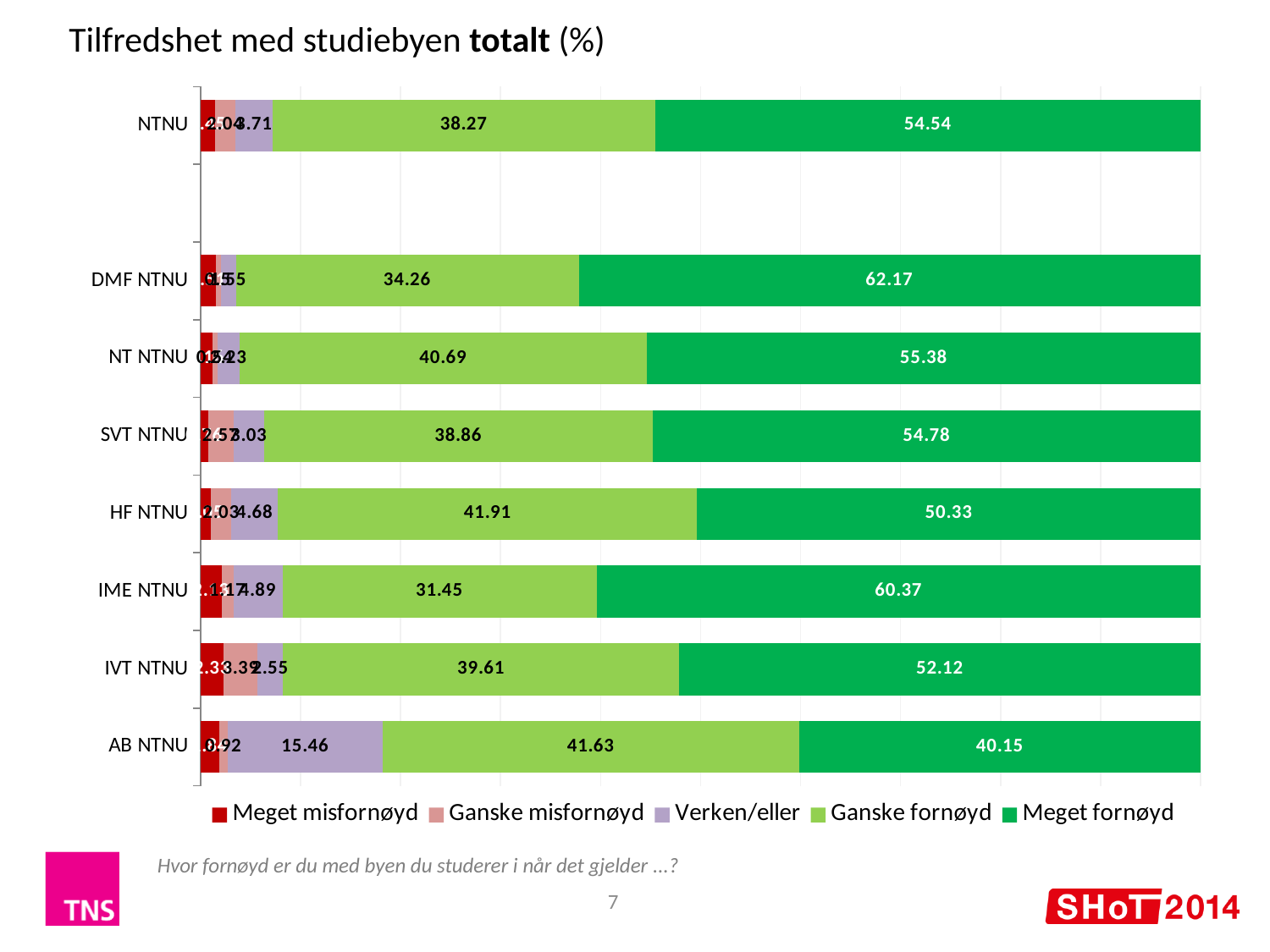
What is the title of the chart? Tilfredshet med studiebyen totalt (%) How many categories (bars) are plotted in the chart? 8 What is the value of 'Ganske fornøyd' for AB NTNU? 41.63 How many series does the legend list? 5 What is the difference between the 'Meget fornøyd' values for DMF NTNU and AB NTNU? 22.02 What is the value of 'Meget fornøyd' for DMF NTNU? 62.17 What is the value of 'Verken/eller' for AB NTNU? 15.46 What is the value of 'Meget fornøyd' for NTNU? 54.54 Which has the larger 'Ganske fornøyd' value, HF NTNU or IME NTNU? HF NTNU Which category has the highest value for 'Meget fornøyd'? DMF NTNU What kind of chart is shown on the slide? bar chart Which category has the lowest value for 'Meget fornøyd'? AB NTNU